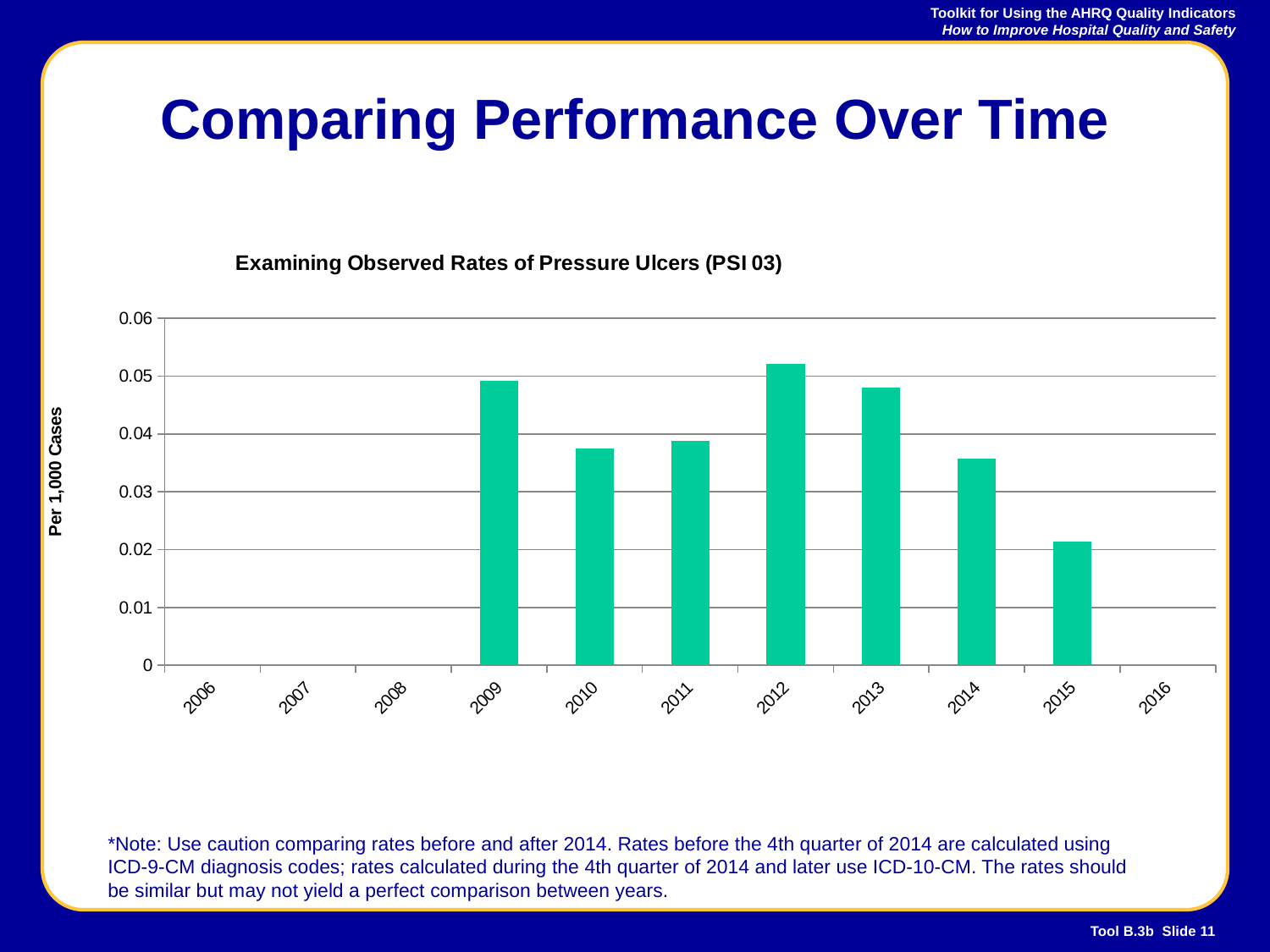
How many years are labeled along the x axis of the chart? 11 How many years have a bar plotted on the chart? 7 What is the label on the vertical axis of the chart? Per 1,000 Cases Is the value for 2010 greater or less than 0.04? less What is the title of the chart? Examining Observed Rates of Pressure Ulcers (PSI 03) Do the values rise or fall from 2013 to 2015? fall Among the years with a bar shown, which year has the lowest observed rate? 2015 Which year has the highest observed rate of pressure ulcers? 2012 Which year has the larger value, 2009 or 2010? 2009 What kind of chart is shown on the slide? bar chart Is the value for 2012 greater or less than 0.05? greater Is the value for 2015 greater or less than 0.03? less